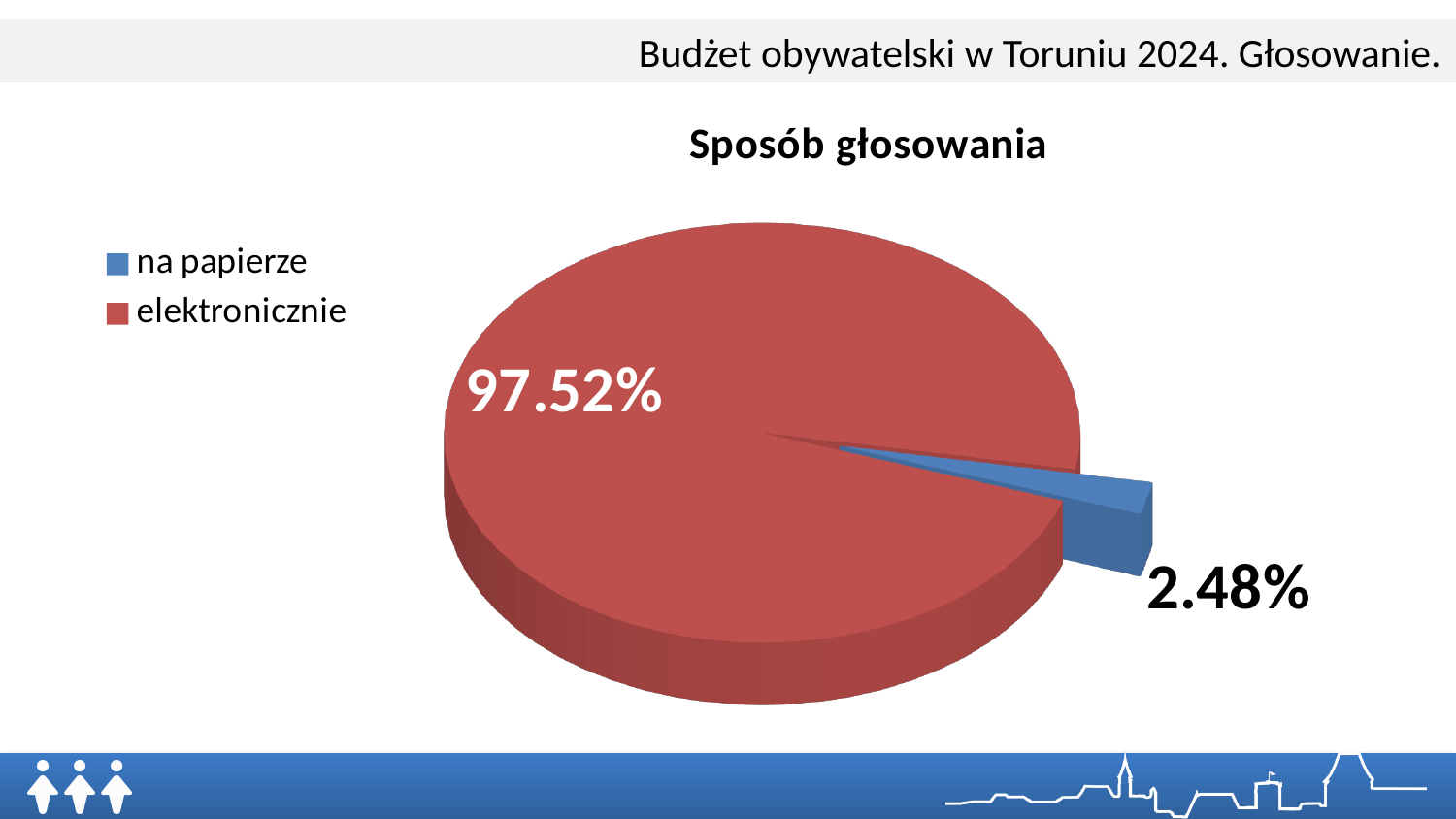
How many entries does the legend list? 2 What colour is the slice for 'na papierze'? blue Which is larger, the share for 'na papierze' or the share for 'elektronicznie'? elektronicznie Which category has the smallest slice of the pie? na papierze Which category has the largest slice of the pie? elektronicznie How many categories does the pie chart show? 2 What is the difference in percentage points between 'elektronicznie' and 'na papierze'? 95.04 What is the title of the chart? Sposób głosowania What share of the pie does 'elektronicznie' represent? 97.52% What type of chart is shown on the slide? pie chart What share of the pie does 'na papierze' represent? 2.48%